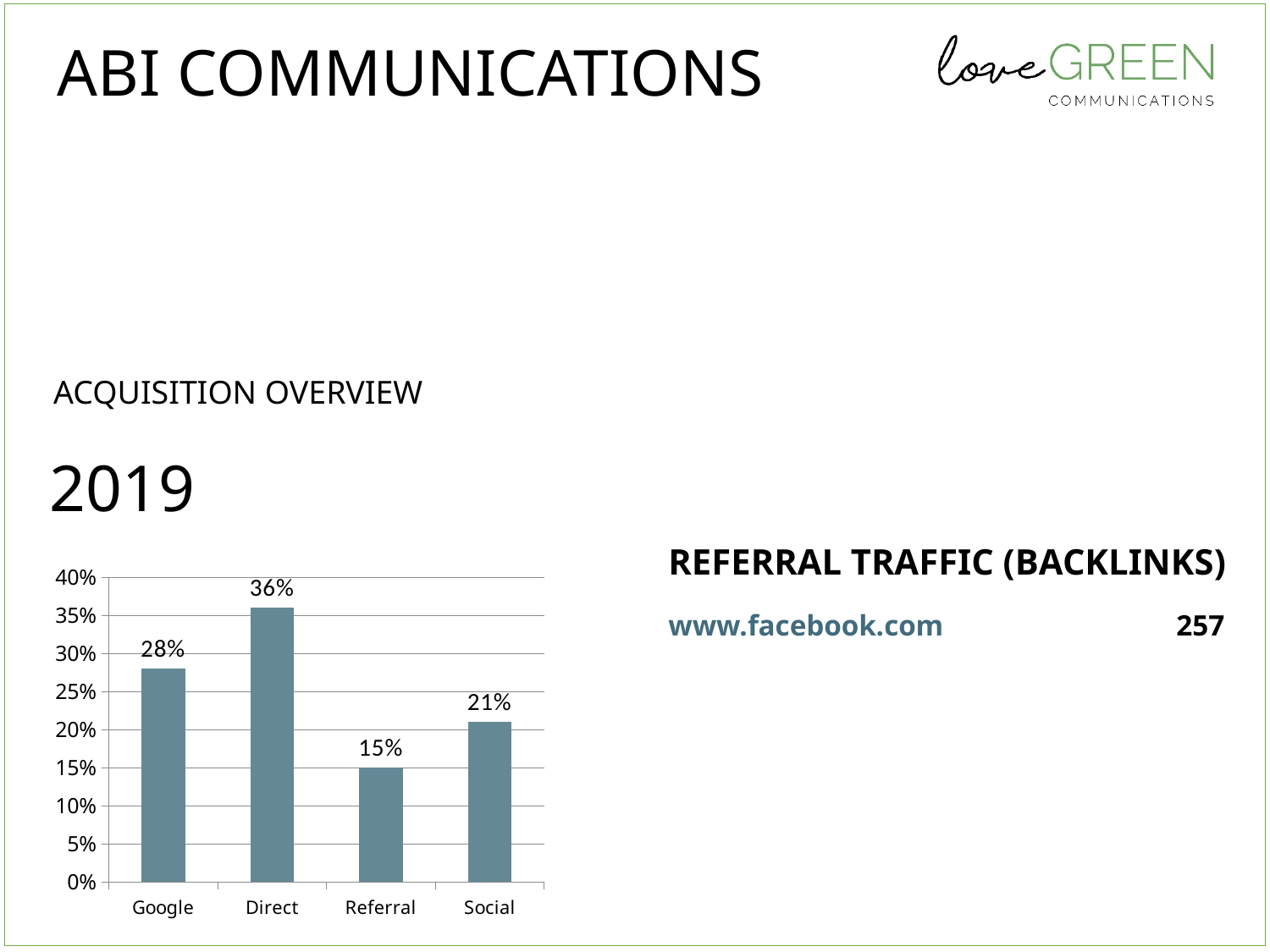
What is the value for Direct? 36% What is the difference between the values for Social and Referral? 6% Which category has the highest value? Direct Which is larger, the value for Google or the value for Social? Google What kind of chart is shown on the slide? bar chart What is the value for Google? 28% Is the value for Social greater or less than 25%? less What is the difference between the values for Direct and Google? 8% What is the value for Social? 21% Which category has the lowest value? Referral What is the value for Referral? 15% How many categories are shown on the x axis? 4